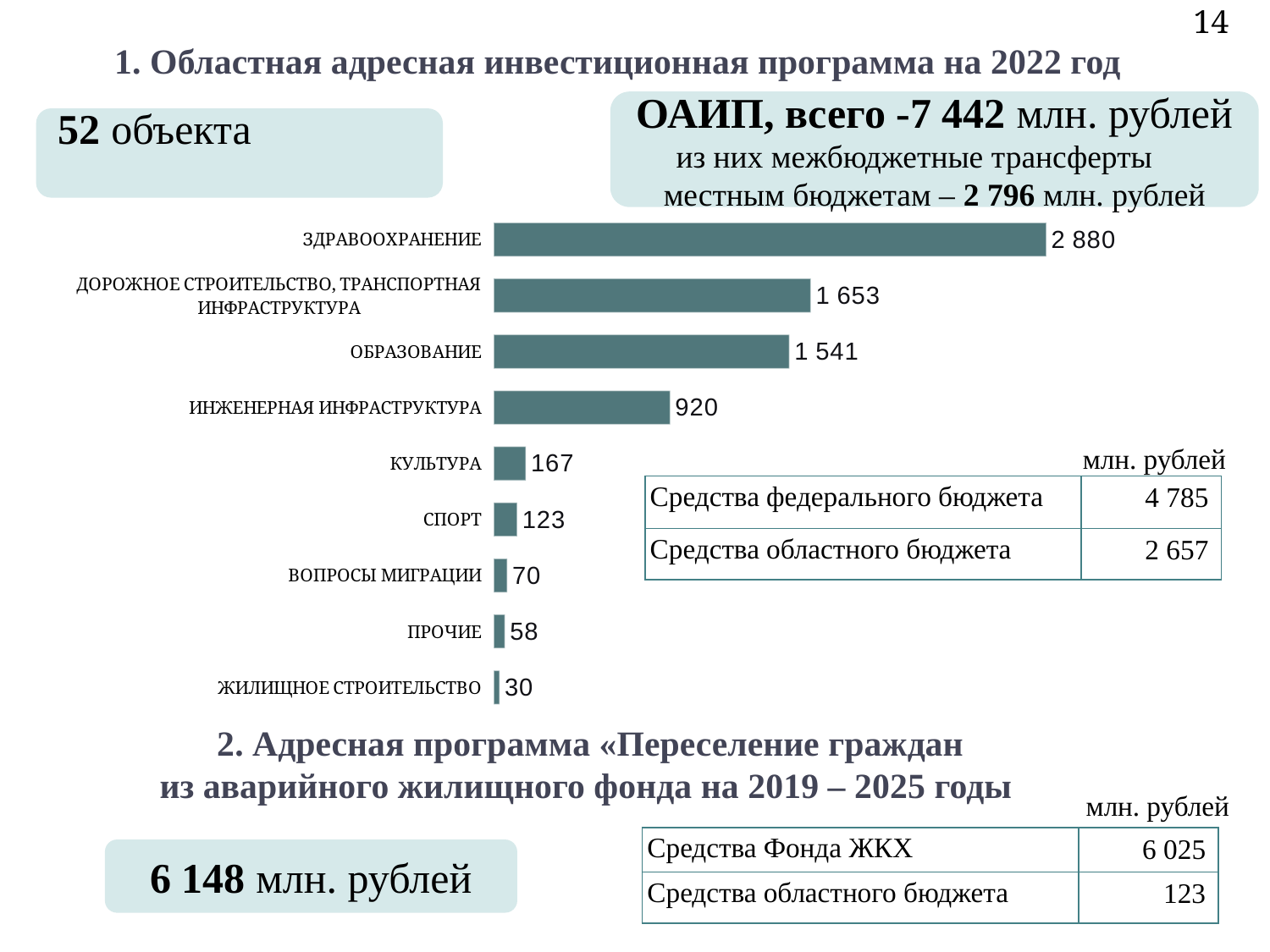
What is the value shown for ЗДРАВООХРАНЕНИЕ in the bar chart? 2 880 What is the value shown for ВОПРОСЫ МИГРАЦИИ in the bar chart? 70 Which category has the highest value in the bar chart? ЗДРАВООХРАНЕНИЕ Which has a larger value in the bar chart, ПРОЧИЕ or ВОПРОСЫ МИГРАЦИИ? ВОПРОСЫ МИГРАЦИИ What type of chart is shown on the slide? Bar chart What is the difference between the values for ЗДРАВООХРАНЕНИЕ and ДОРОЖНОЕ СТРОИТЕЛЬСТВО, ТРАНСПОРТНАЯ ИНФРАСТРУКТУРА in the bar chart? 1 227 What is the difference between the values for КУЛЬТУРА and СПОРТ in the bar chart? 44 How many categories are shown in the bar chart? 9 What is the value shown for ИНЖЕНЕРНАЯ ИНФРАСТРУКТУРА in the bar chart? 920 Which has a larger value in the bar chart, ОБРАЗОВАНИЕ or ИНЖЕНЕРНАЯ ИНФРАСТРУКТУРА? ОБРАЗОВАНИЕ Which category has the lowest value in the bar chart? ЖИЛИЩНОЕ СТРОИТЕЛЬСТВО What is the value shown for ОБРАЗОВАНИЕ in the bar chart? 1 541